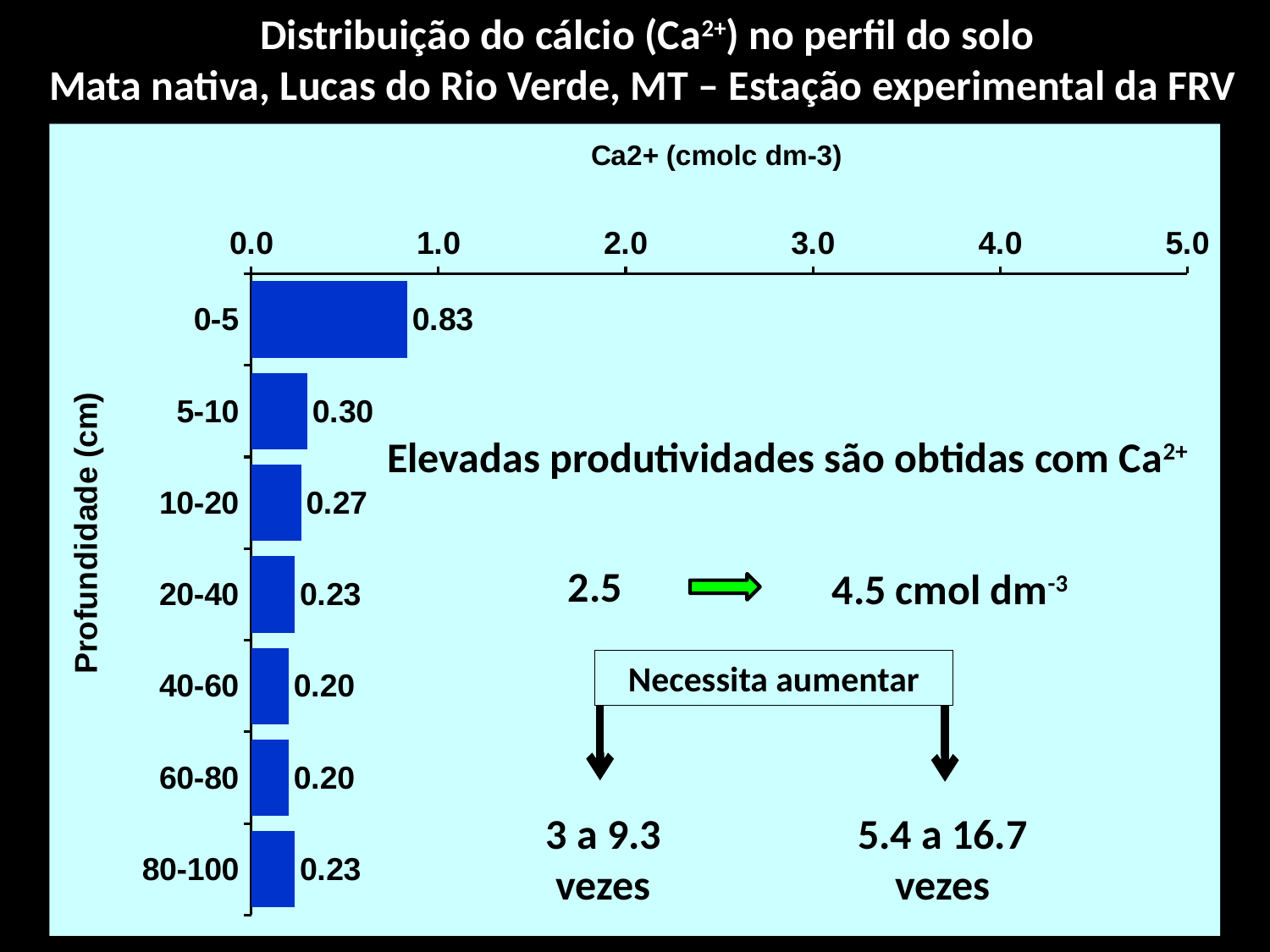
What is the maximum value shown on the horizontal axis of the chart? 5.0 What is the Ca2+ value for the 10-20 cm depth? 0.27 What is the Ca2+ value for the 0-5 cm depth? 0.83 Which has a larger Ca2+ value, the 5-10 cm depth or the 40-60 cm depth? 5-10 How many depth categories are shown in the chart? 7 What is the difference between the Ca2+ values for the 5-10 and 20-40 cm depths? 0.07 What is the difference between the Ca2+ values for the 0-5 and 5-10 cm depths? 0.53 What is the Ca2+ value for the 80-100 cm depth? 0.23 Is the Ca2+ value for the 0-5 cm depth greater or less than 1.0? less What kind of chart is shown on the slide? bar chart Which depth has the highest Ca2+ value? 0-5 What is the label of the vertical axis of the chart? Profundidade (cm)